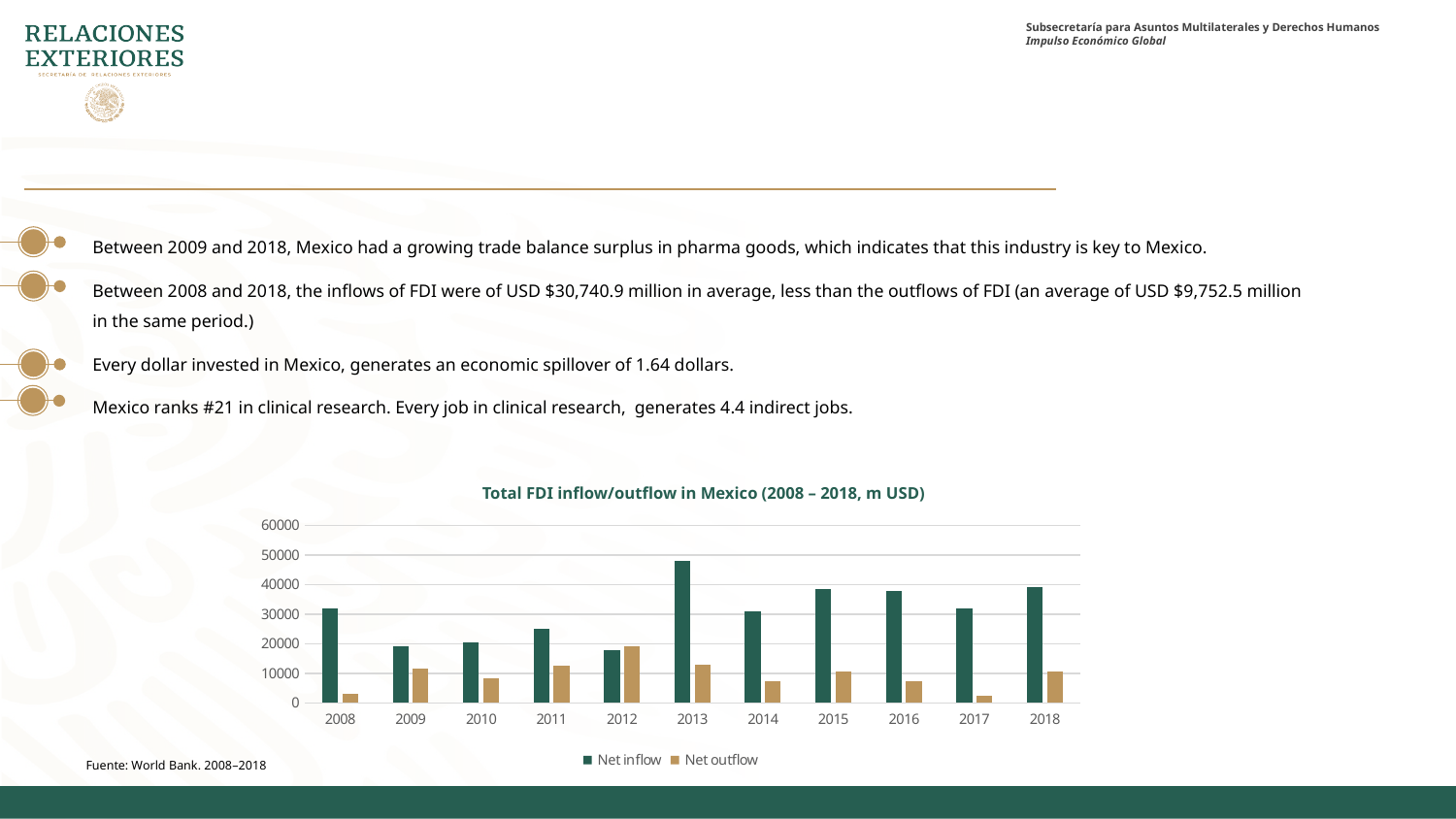
Is the Net outflow for 2017 greater or less than 10000? less How many series does the chart's legend list? 2 Is the Net outflow for 2012 greater or less than 10000? greater Is the Net inflow for 2011 greater or less than 20000? greater How many years are shown on the x axis of the chart? 11 In which year is the Net outflow highest? 2012 Which is larger, the Net inflow in 2013 or the Net inflow in 2018? 2013 Which colour represents Net outflow in the chart? Tan (gold) What kind of chart is shown on the slide? Bar chart What is the title of the chart? Total FDI inflow/outflow in Mexico (2008 – 2018, m USD) In which year is the Net inflow highest? 2013